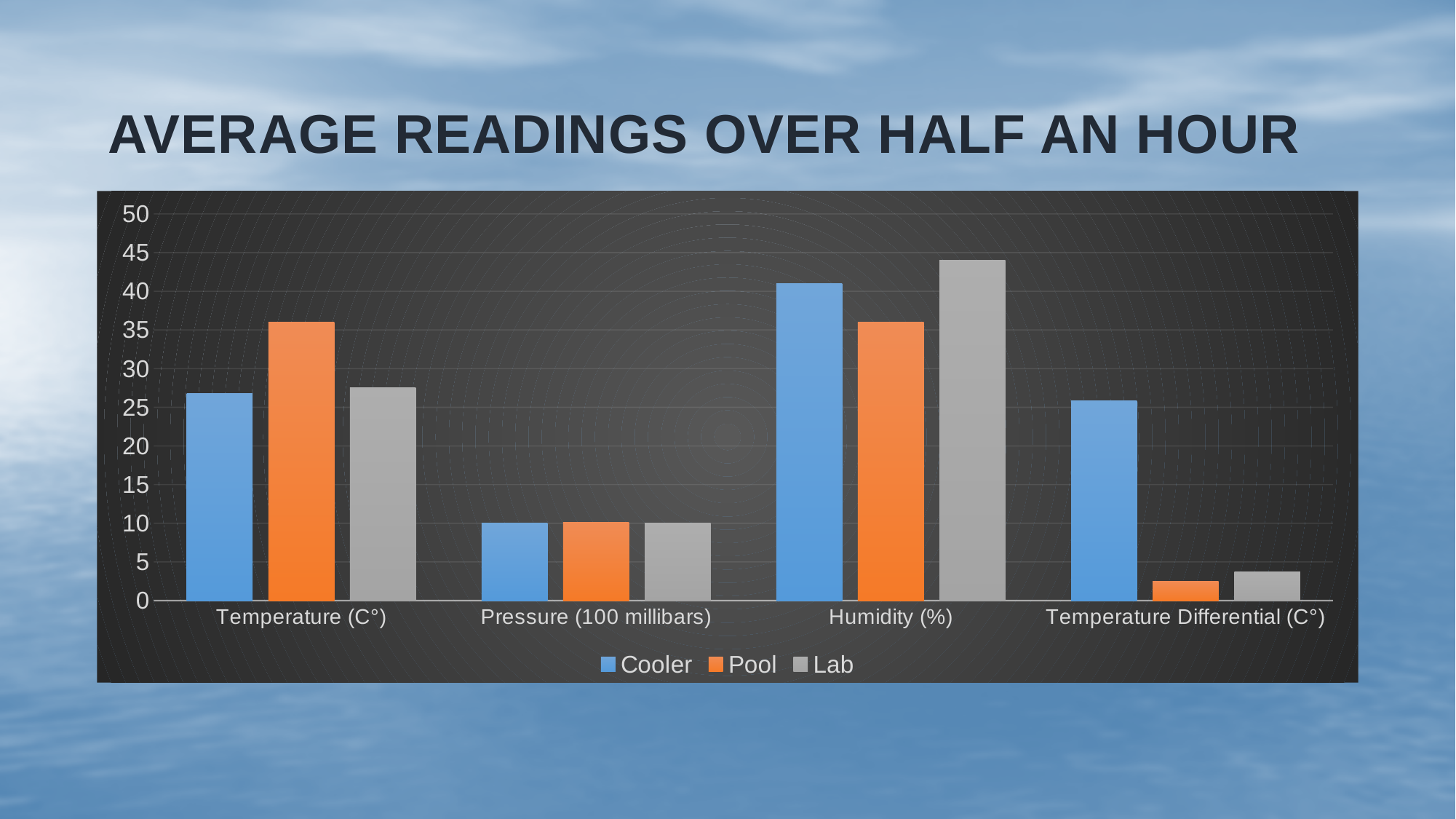
How many series does the legend list? 3 Which series has the lowest value for Temperature Differential (C°)? Pool Is the Lab value for Humidity (%) greater or less than 45? less Is the Cooler value for Humidity (%) greater or less than 40? greater How many categories are shown on the x axis? 4 What kind of chart is shown on the slide? bar chart Is the Pool value for Temperature Differential (C°) greater or less than 5? less Which series has the highest value for Humidity (%)? Lab Which series is shown in orange? Pool What is the title of the slide? AVERAGE READINGS OVER HALF AN HOUR Which is larger: the Cooler value for Humidity (%) or the Cooler value for Temperature (C°)? Humidity (%) Which series has the highest value for Temperature (C°)? Pool